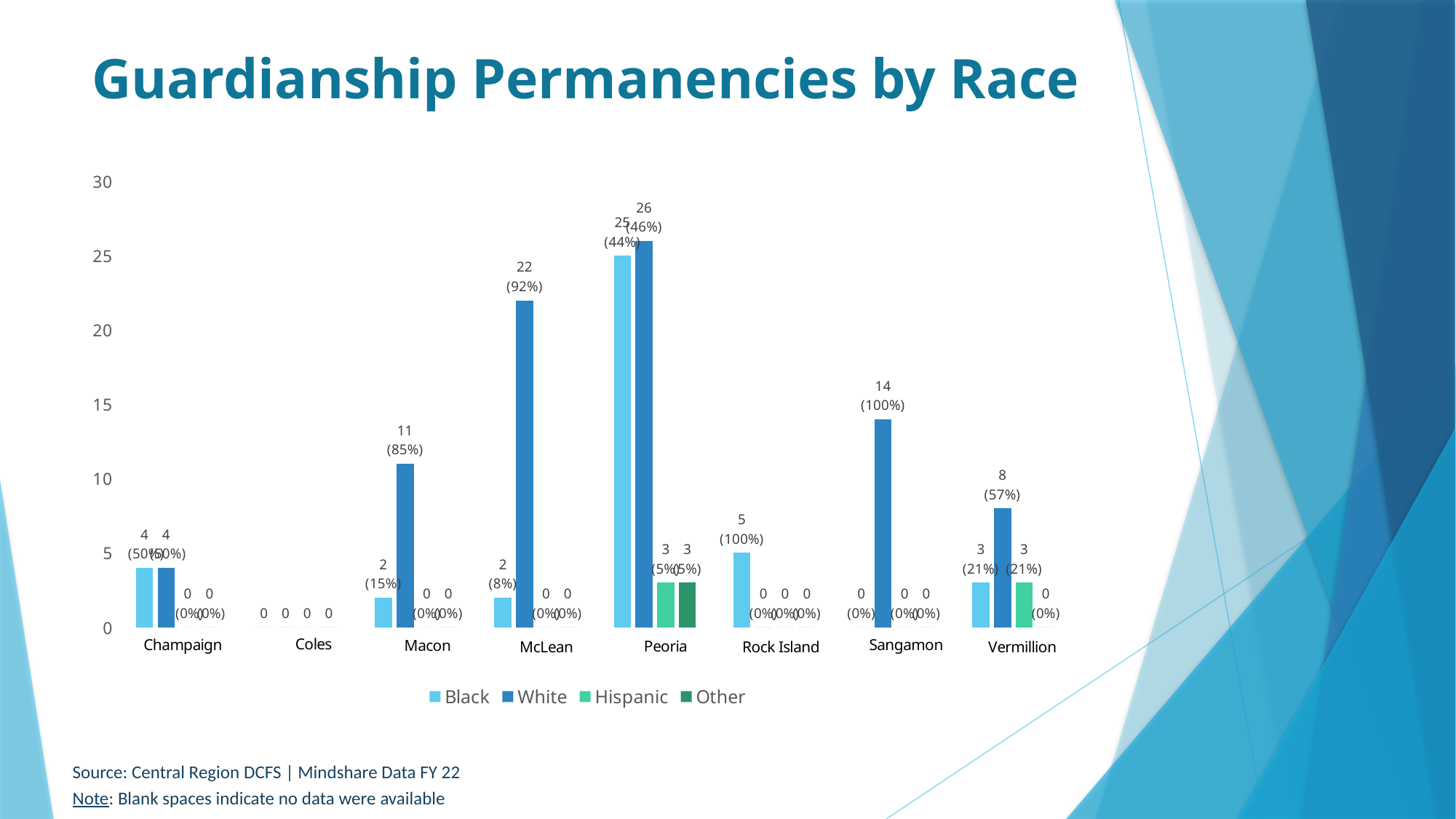
How many counties are shown on the x axis? 8 What type of chart is shown on the slide? Bar chart What is the value for White in McLean? 22 What is the difference between the White and Black values in Macon? 9 Which county has the highest Black value? Peoria How many series does the legend list? 4 What percentage is shown for White in Macon? 85% What is the title of the chart? Guardianship Permanencies by Race Which is larger in Vermillion, the White value or the Black value? White What is the value for Hispanic in Vermillion? 3 What is the value for Black in Peoria? 25 Which county has the highest White value? Peoria